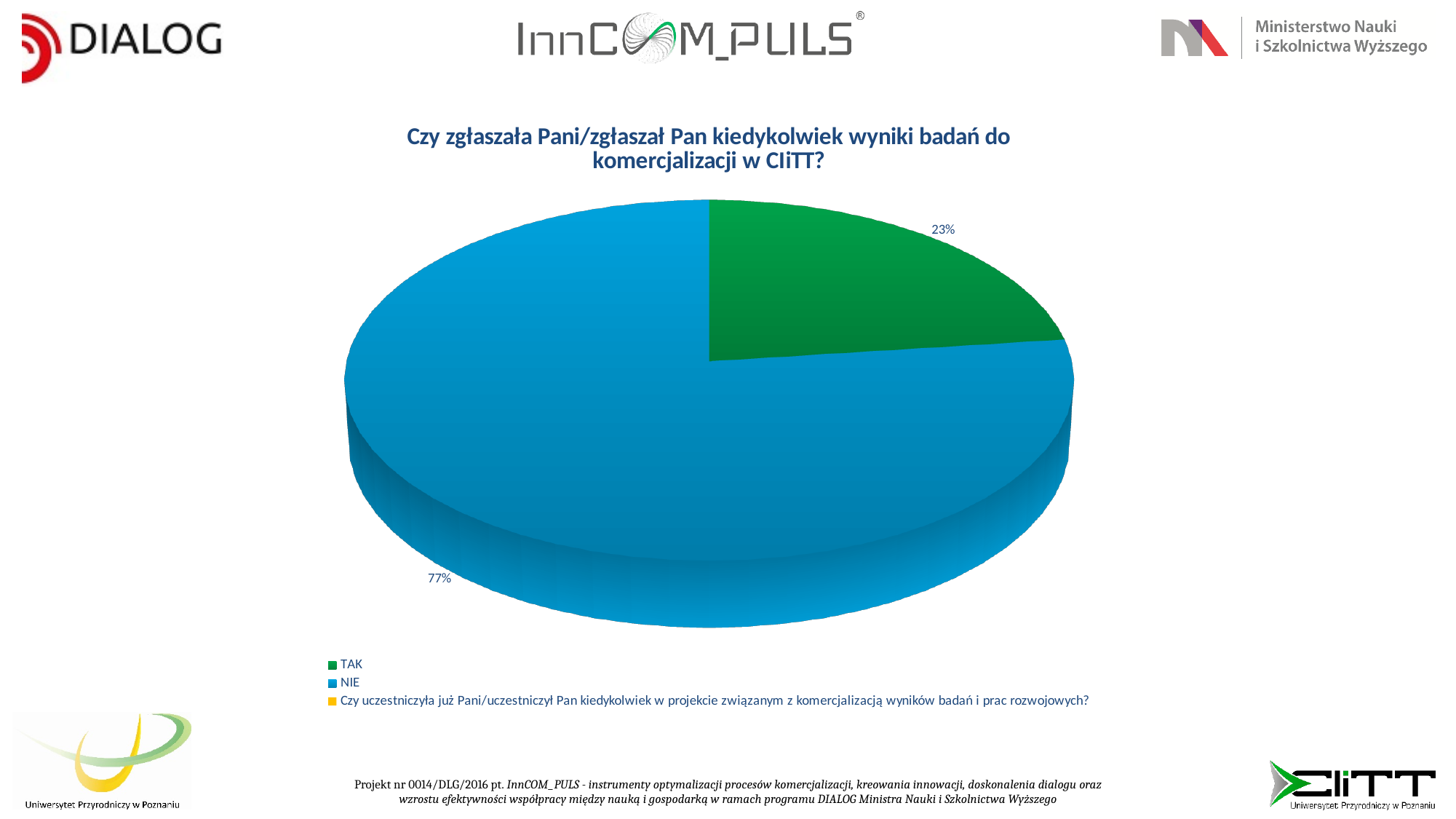
What is the title of the chart? Czy zgłaszała Pani/zgłaszał Pan kiedykolwiek wyniki badań do komercjalizacji w CIiTT? How many entries does the legend list? 3 Which answer has the smallest share of the pie? TAK Which is larger, the share for TAK or the share for NIE? NIE By how many percentage points does NIE exceed TAK? 54 percentage points What percentage of respondents answered NIE? 77% What percentage of respondents answered TAK? 23% How many slices are visible in the pie? 2 What kind of chart is shown on the slide? Pie chart What share of the pie does the NIE slice represent? 77% Which answer has the largest share of the pie? NIE What colour is the TAK slice? Green